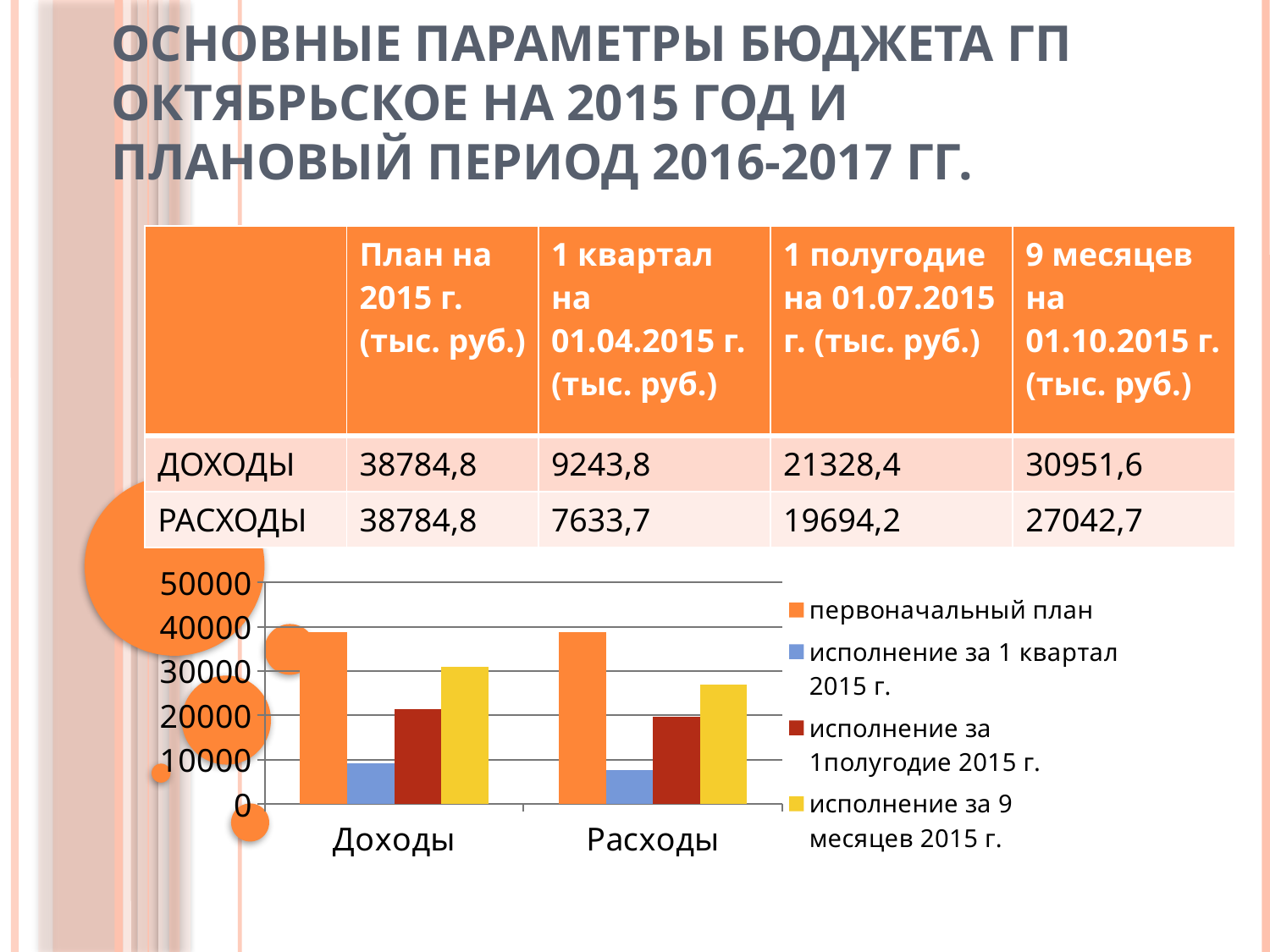
Which is larger in the chart: исполнение за 9 месяцев 2015 г. for Доходы or for Расходы? Доходы Which series in the chart has the shortest bar for Расходы? исполнение за 1 квартал 2015 г. What kind of chart is shown on the slide? bar chart Is the value of первоначальный план for Расходы greater or less than 40000? less Which series in the chart has the tallest bar for Доходы? первоначальный план How many series does the chart legend list? 4 How many categories are shown on the x axis of the chart? 2 Is the value of первоначальный план for Доходы greater or less than 30000? greater Is the value of исполнение за 1 квартал 2015 г. for Расходы greater or less than 10000? less What colour are the bars for the series первоначальный план? orange What is the highest value shown on the chart's vertical axis? 50000